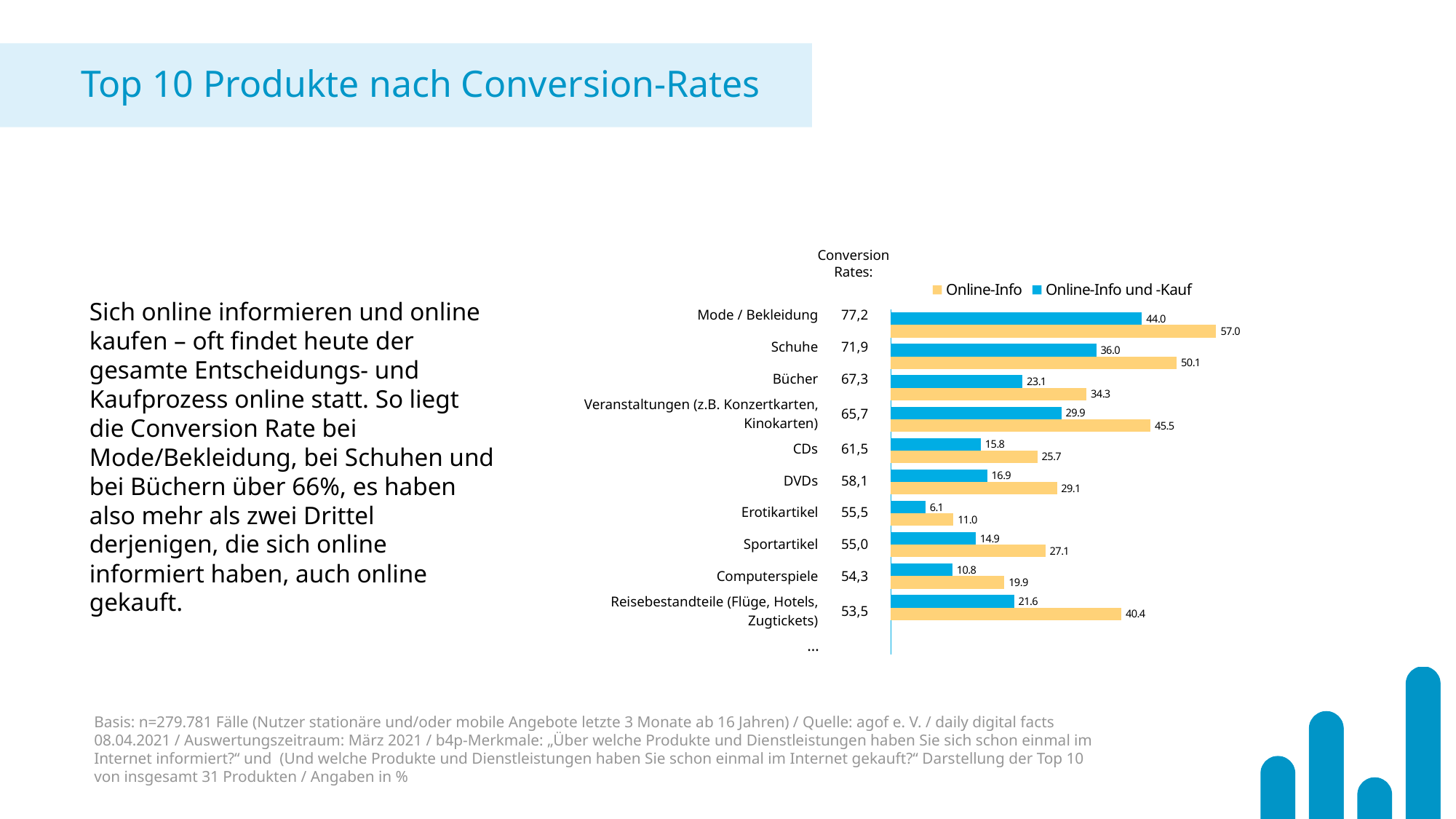
What is the Online-Info value for Reisebestandteile (Flüge, Hotels, Zugtickets)? 40.4 Which colour represents the Online-Info series in the chart? Yellow Which category has the lowest Online-Info value? Erotikartikel What is the difference between the Online-Info and the Online-Info und -Kauf values for Schuhe? 14.1 How many series does the legend list? 2 Which category has the highest Online-Info und -Kauf value? Mode / Bekleidung What kind of chart is shown on the slide? Bar chart What is the Online-Info value for Mode / Bekleidung? 57.0 What is the Online-Info und -Kauf value for Veranstaltungen (z.B. Konzertkarten, Kinokarten)? 29.9 Which is larger: the Online-Info value for CDs or the Online-Info value for DVDs? DVDs What is the difference between the Online-Info und -Kauf values for Mode / Bekleidung and Schuhe? 8.0 What is the Online-Info und -Kauf value for Bücher? 23.1